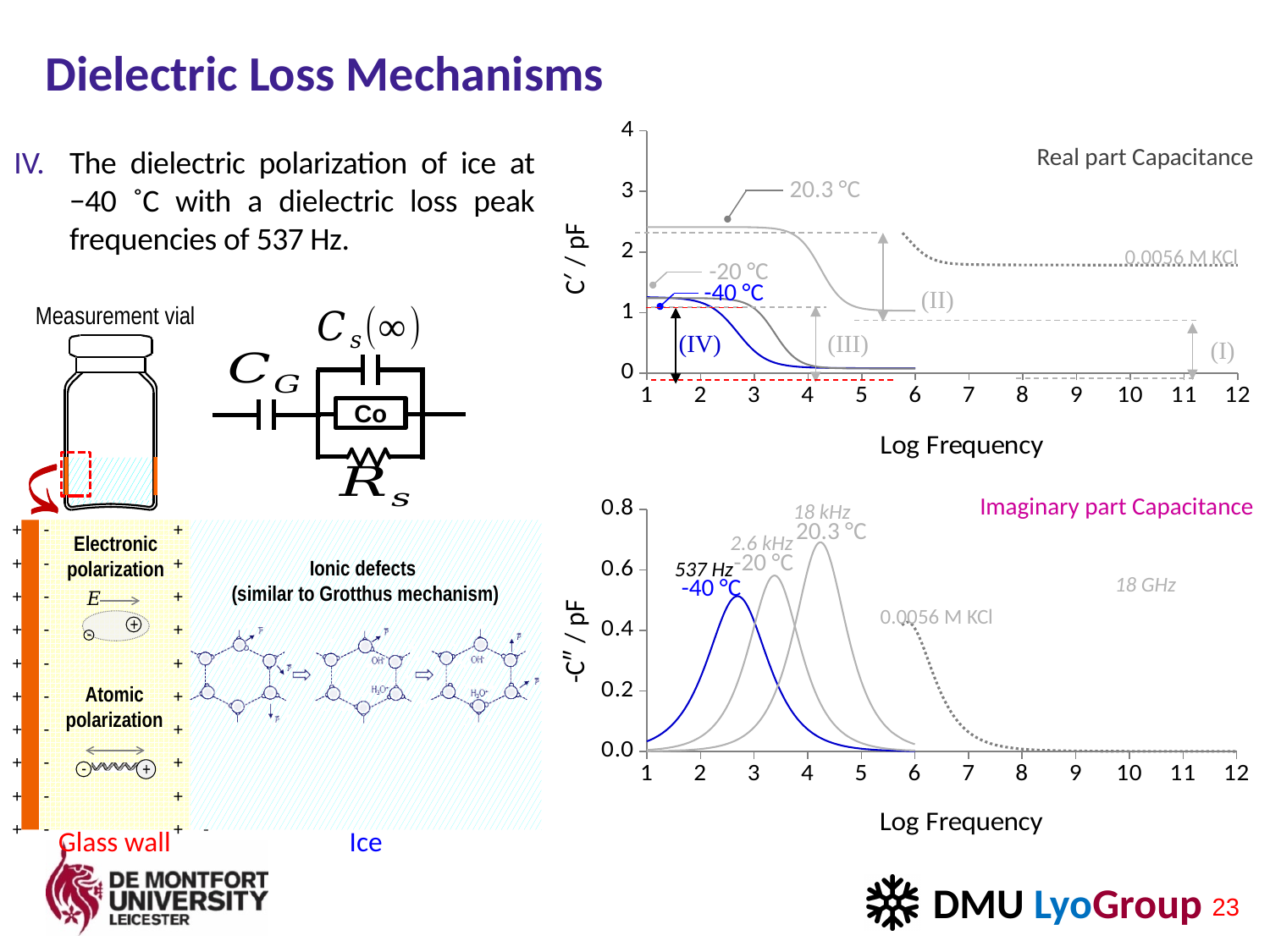
In the Imaginary part Capacitance chart, what peak frequency is labelled for the 0.0056 M KCl curve? 18 GHz In the Imaginary part Capacitance chart, is the peak value of the 20.3 °C curve greater or less than 0.6? greater In the Real part Capacitance chart, does the 20.3 °C curve rise or fall as Log Frequency increases? fall In the Real part Capacitance chart, is the low-frequency plateau of the 20.3 °C curve greater or less than 2? greater In the Imaginary part Capacitance chart, what is the loss peak frequency labelled for the 20.3 °C curve? 18 kHz What is the x-axis label of the Imaginary part Capacitance chart? Log Frequency In the Imaginary part Capacitance chart, what is the loss peak frequency labelled for the -40 °C curve? 537 Hz In the Imaginary part Capacitance chart, is the peak value of the -40 °C curve greater or less than 0.6? less What kind of chart is the Real part Capacitance chart? line chart In the Imaginary part Capacitance chart, what is the loss peak frequency labelled for the -20 °C curve? 2.6 kHz In the Imaginary part Capacitance chart, which of the three ice curves (-40 °C, -20 °C, 20.3 °C) has the highest peak? 20.3 °C